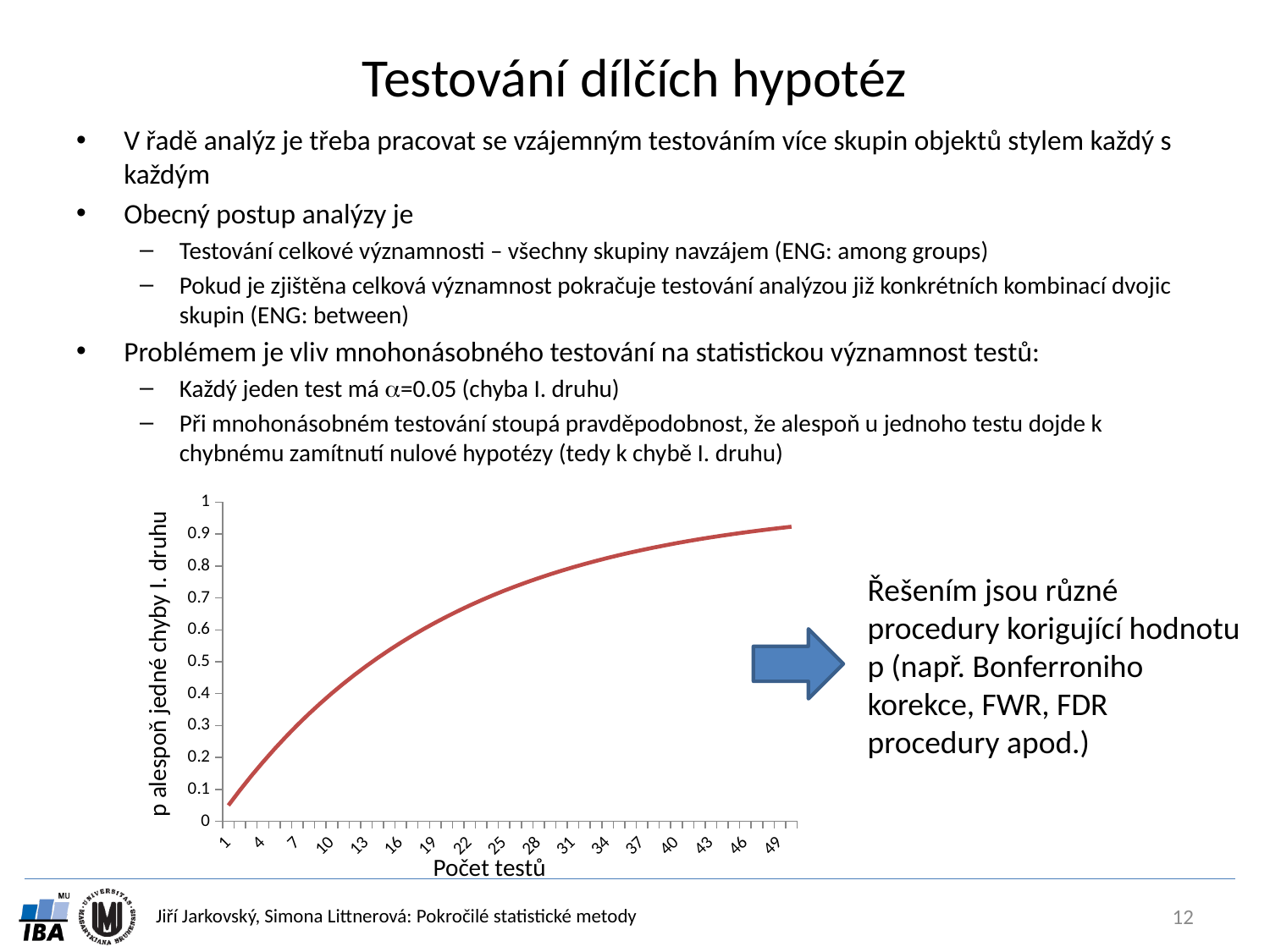
How many lines are plotted on the chart? 1 At which number of tests is the plotted value lowest? 1 Is the value for 10 tests greater or less than 0.3? greater What is the label of the y axis of the chart? p alespoň jedné chyby I. druhu Is the value for 1 test greater or less than 0.1? less Which is larger, the value for 7 tests or the value for 40 tests? 40 tests What kind of chart is shown on the slide? line chart Is the value for 49 tests greater or less than 0.8? greater What is the label of the x axis of the chart? Počet testů Do the values on the chart rise or fall as the number of tests (Počet testů) increases? rise